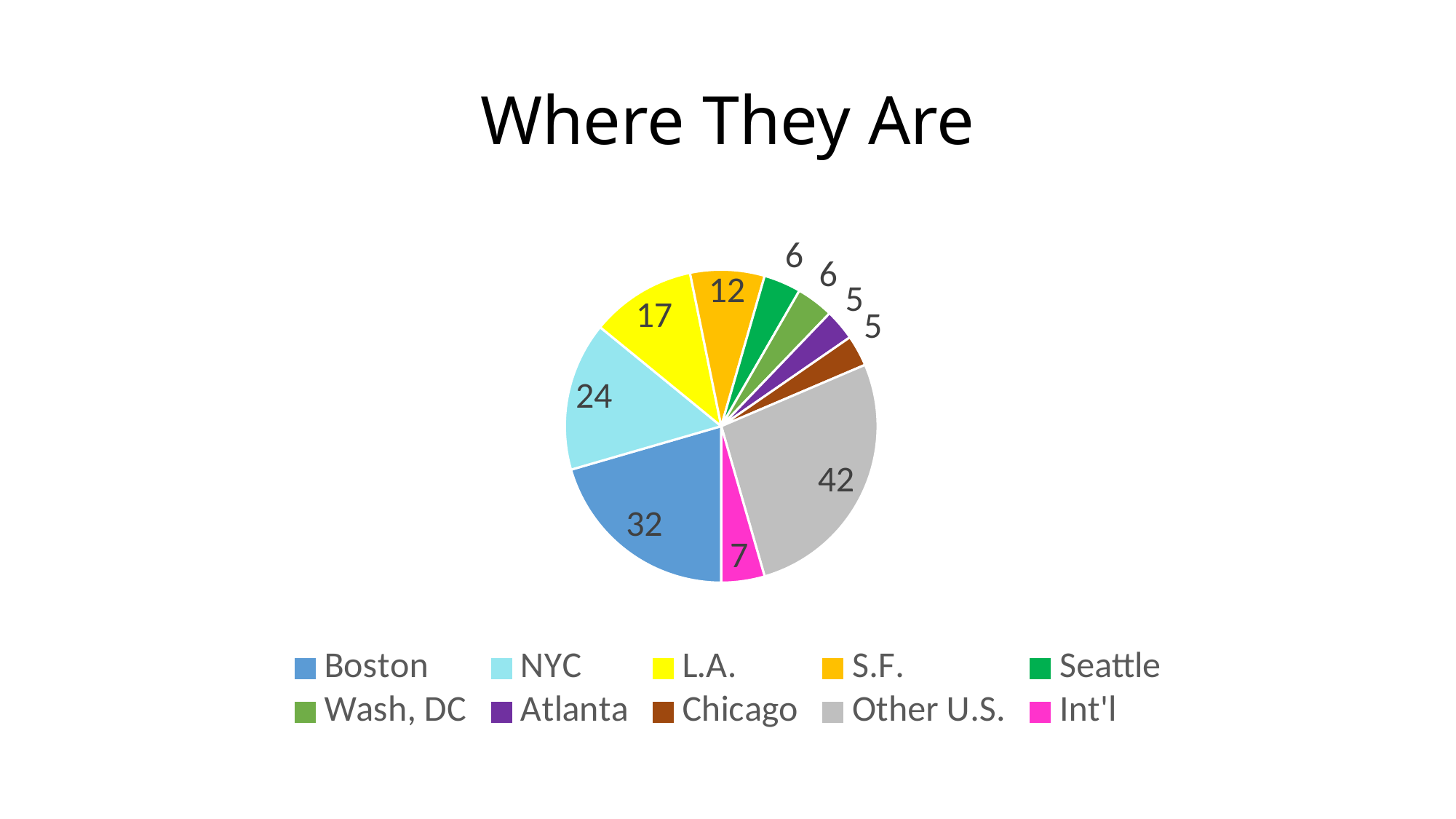
What is the value for Boston? 32 What is the value for Other U.S.? 42 What kind of chart is shown on the slide? pie chart What is the title of the chart? Where They Are What is the value for L.A.? 17 How many categories does the pie chart have? 10 Which is larger, the value for NYC or the value for L.A.? NYC Which category has the largest slice? Other U.S. What is the difference between the values for Other U.S. and Boston? 10 What is the value for Int'l? 7 What is the value for NYC? 24 What colour is the slice for S.F.? orange